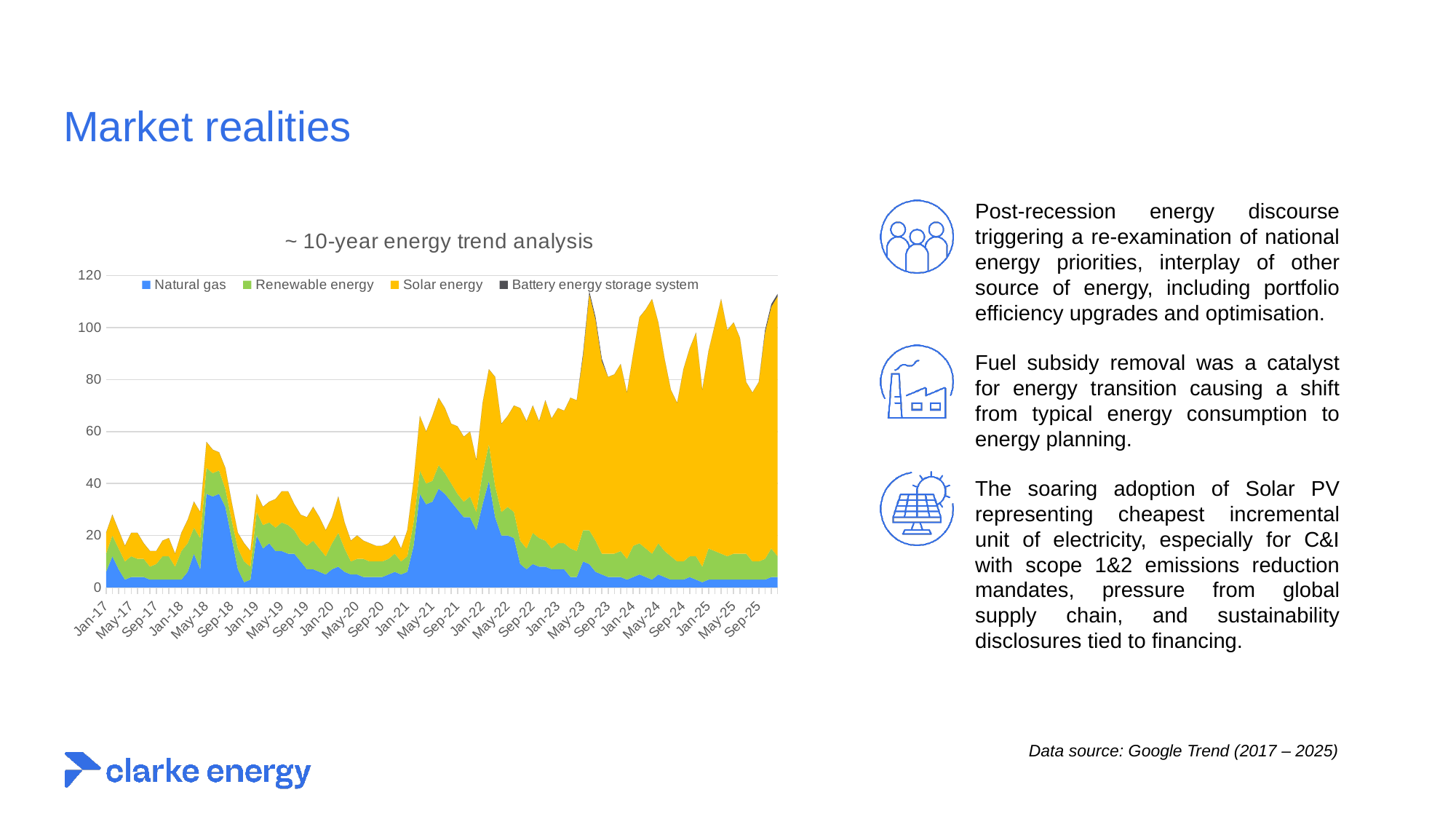
How many series does the chart legend list? 4 In 2024, which series is larger: Solar energy or Natural gas? Solar energy What is the highest value shown on the chart's vertical axis? 120 What is the last date label on the chart's horizontal axis? Sep-25 How many date labels are shown on the chart's horizontal axis? 27 Is the stacked total at Sep-20 greater or less than 40? less Does the Solar energy series generally rise or fall from 2017 to 2025? Rise What is the first date label on the chart's horizontal axis? Jan-17 What kind of chart is shown on the slide? Stacked area chart What is the title of the chart? ~ 10-year energy trend analysis Which series is shown in yellow in the chart? Solar energy Is the stacked total at Jan-17 greater or less than 40? less